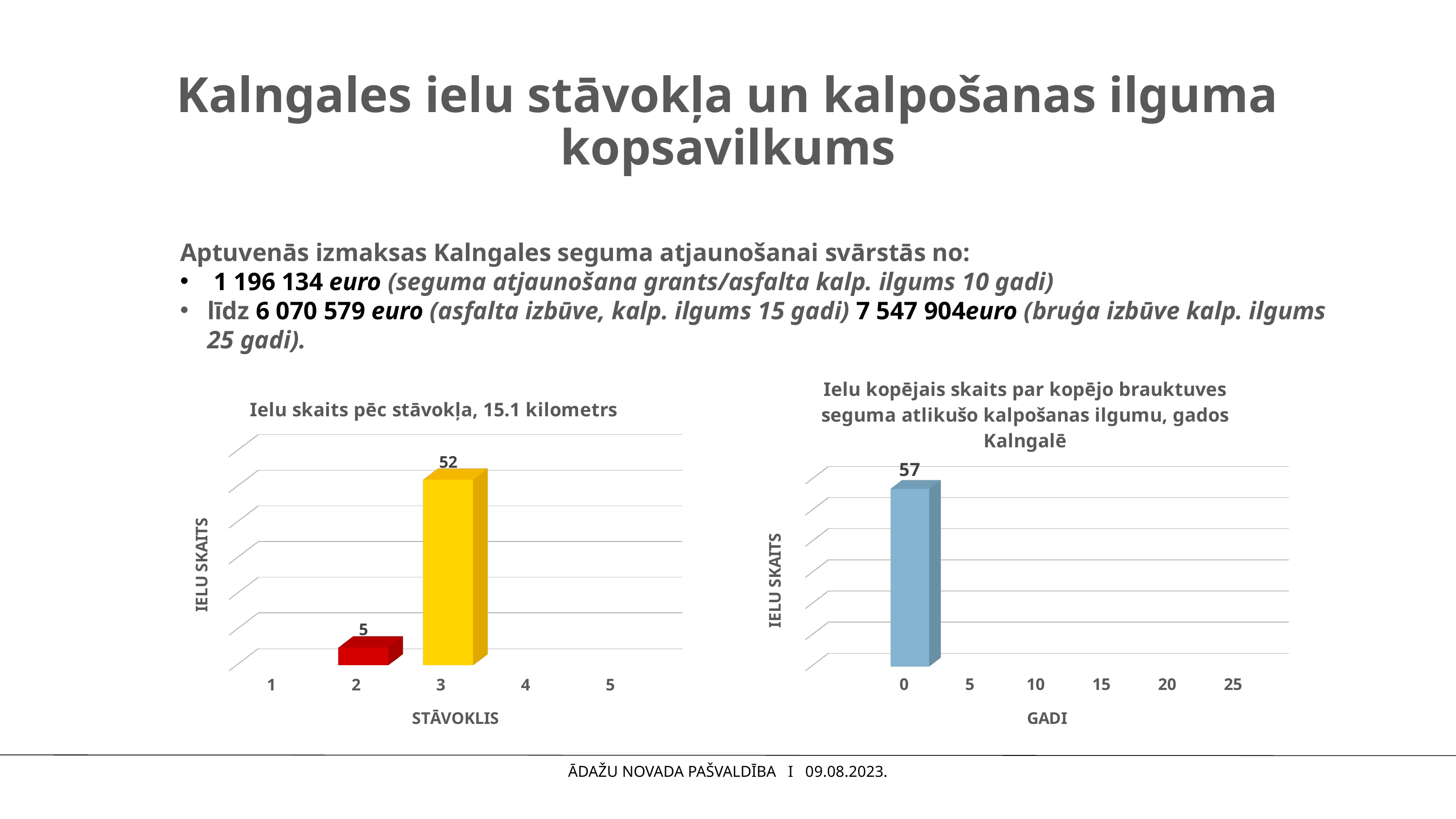
In the chart titled "Ielu skaits pēc stāvokļa, 15.1 kilometrs", what is the value for category 2? 5 What kind of chart is the right chart? bar chart What is the x-axis title of the right chart? GADI In the right chart, how many categories are shown on the x axis? 6 In the right chart, what is the value for category 0 on the GADI axis? 57 In the left chart, which category has the highest value? 3 In the left chart, what is the difference between the values for category 3 and category 2? 47 What kind of chart is the left chart, "Ielu skaits pēc stāvokļa, 15.1 kilometrs"? bar chart What is the x-axis title of the left chart? STĀVOKLIS In the chart titled "Ielu skaits pēc stāvokļa, 15.1 kilometrs", what is the value for category 3? 52 In the left chart, how many categories are shown on the x axis? 5 In the left chart, which is larger: the value for category 2 or the value for category 3? 3